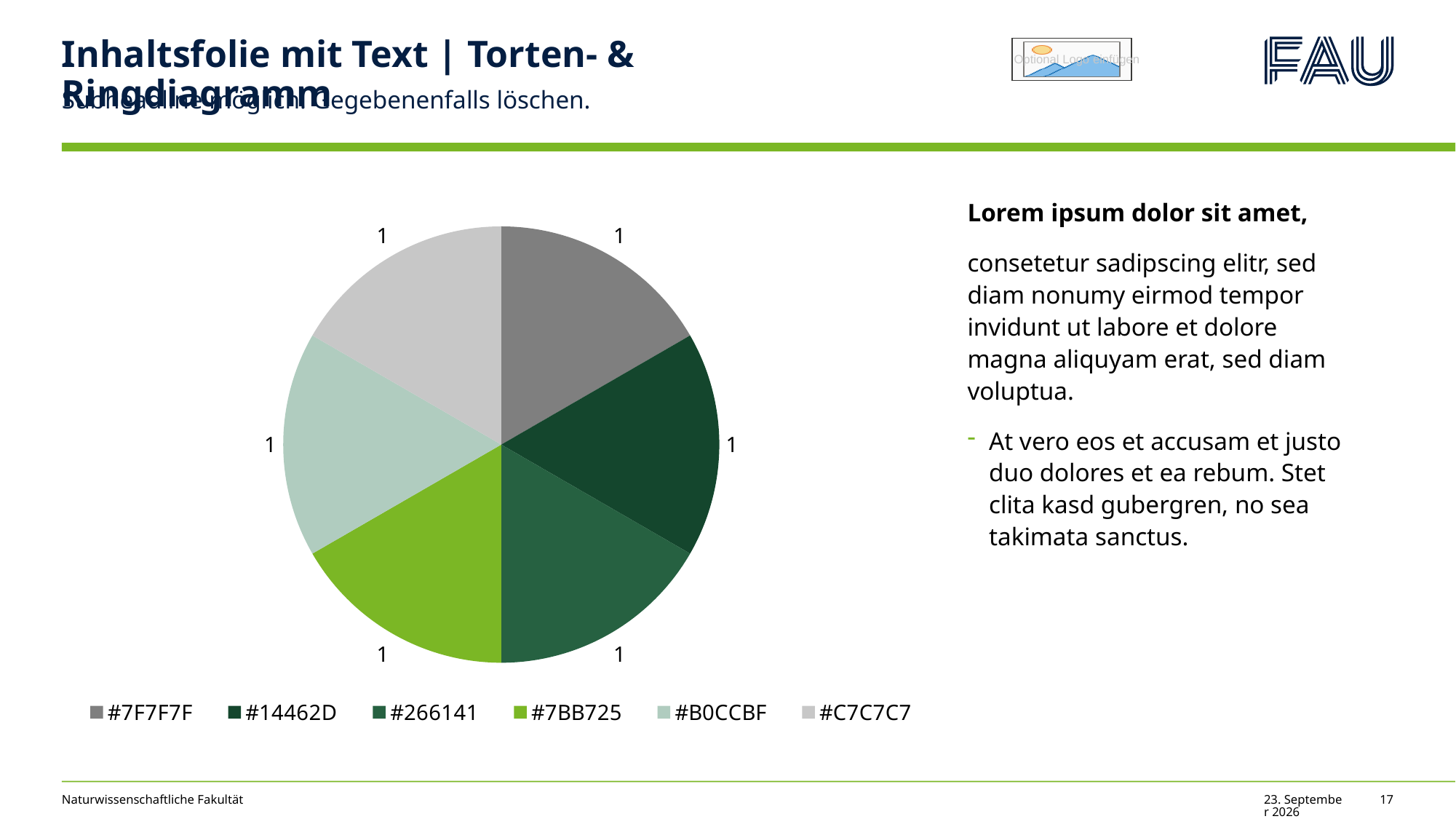
What kind of chart is shown on the slide? pie chart What is the difference between the values of the #266141 and #B0CCBF slices? 0 What is the value of the #7F7F7F slice in the pie chart? 1 Which legend entry is listed last in the pie chart's legend? #C7C7C7 How many slices does the pie chart have? 6 What is the value of the #C7C7C7 slice in the pie chart? 1 What share of the pie does the #B0CCBF slice represent? 1/6 What is the value of the #14462D slice in the pie chart? 1 What is the total of all slice values in the pie chart? 6 Which legend entry is listed first in the pie chart's legend? #7F7F7F How many entries does the legend of the pie chart list? 6 What is the value of the #7BB725 slice in the pie chart? 1